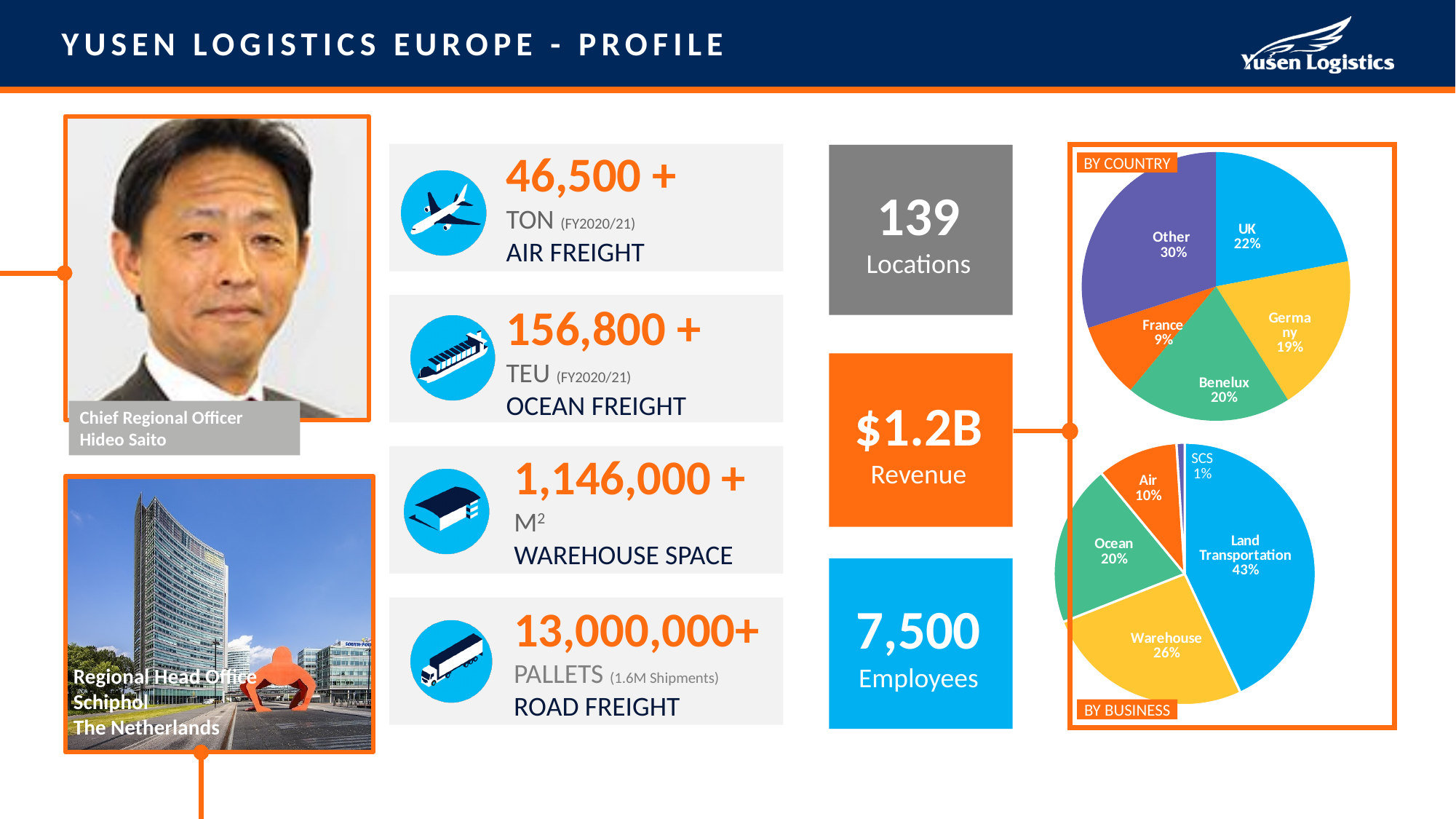
In the 'BY COUNTRY' pie chart, what is the difference between the Benelux share and the Germany share? 1% In the 'BY COUNTRY' pie chart, which slice is the smallest? France In the 'BY BUSINESS' pie chart, what share does SCS have? 1% In the 'BY BUSINESS' pie chart, which is larger, Warehouse or Ocean? Warehouse In the 'BY COUNTRY' pie chart, how many slices are there? 5 In the 'BY BUSINESS' pie chart, what is the difference between the Warehouse share and the Air share? 16% In the 'BY BUSINESS' pie chart, which slice is the largest? Land Transportation In the 'BY COUNTRY' pie chart, which slice is the largest? Other In the 'BY BUSINESS' pie chart, what share does Land Transportation have? 43% In the 'BY COUNTRY' pie chart, what share does the UK have? 22% In the 'BY COUNTRY' pie chart, what share does France have? 9% What type of chart is used for the 'BY BUSINESS' breakdown? Pie chart